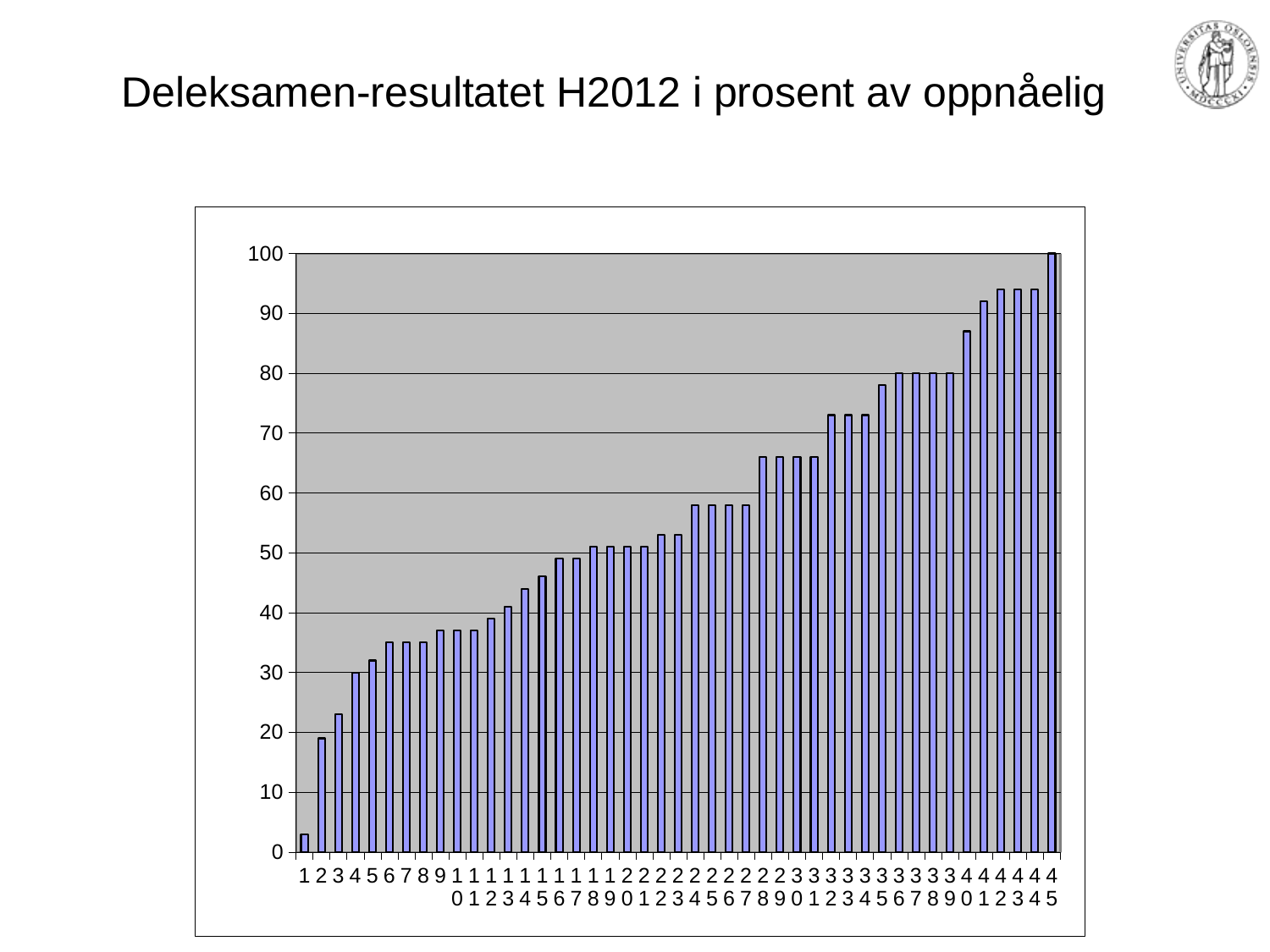
Which category has the highest value? 45 Which category has the lowest value? 1 Which is larger, the value for category 10 or the value for category 40? category 40 Is the value for category 1 greater or less than 10? less Is the value for category 20 greater or less than 60? less Is the value for category 41 greater or less than 90? greater What kind of chart is shown on the slide? bar chart Do the values rise or fall from left to right along the x axis? rise How many bars (categories) are plotted in the chart? 45 What is the title of the slide containing the chart? Deleksamen-resultatet H2012 i prosent av oppnåelig